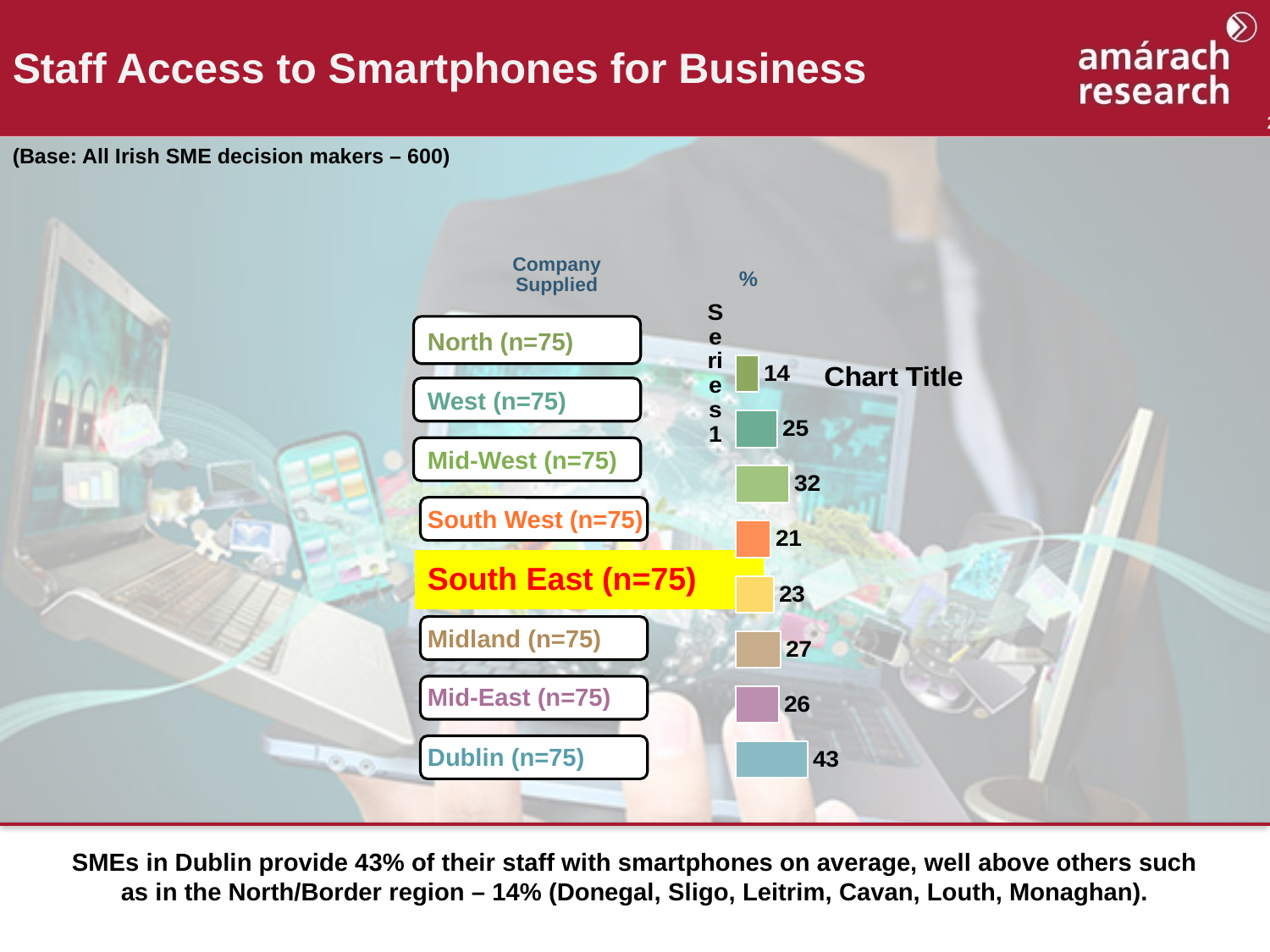
Which region has the lowest value? North (n=75) What is the value for North (n=75)? 14 What kind of chart is shown on the slide? Bar chart Which region has the highest value? Dublin (n=75) What is the difference between the values for Dublin (n=75) and North (n=75)? 29 How many regions are plotted in the chart? 8 What is the value for Dublin (n=75)? 43 What is the value for South East (n=75)? 23 Which is larger, the value for Midland (n=75) or the value for Mid-East (n=75)? Midland (n=75) What is the value for Mid-West (n=75)? 32